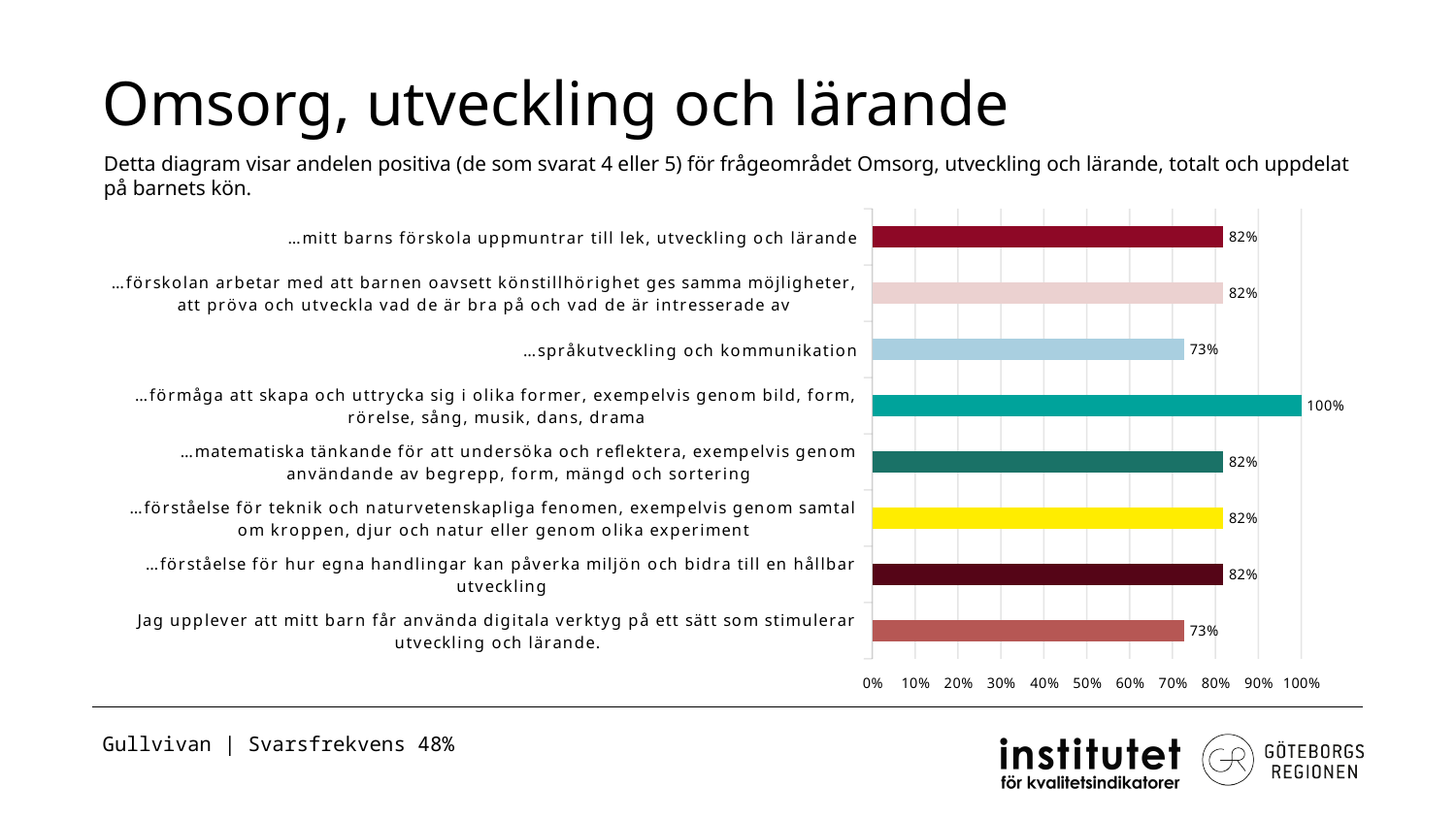
What is the value for "…förmåga att skapa och uttrycka sig i olika former, exempelvis genom bild, form, rörelse, sång, musik, dans, drama"? 100% How many categories are shown in the chart? 8 What is the value for "…språkutveckling och kommunikation"? 73% Which category has the highest value? …förmåga att skapa och uttrycka sig i olika former, exempelvis genom bild, form, rörelse, sång, musik, dans, drama What is the difference between the value for "…förmåga att skapa och uttrycka sig i olika former, exempelvis genom bild, form, rörelse, sång, musik, dans, drama" and the value for "…språkutveckling och kommunikation"? 27% Which is larger: the value for "…matematiska tänkande för att undersöka och reflektera, exempelvis genom användande av begrepp, form, mängd och sortering" or the value for "…språkutveckling och kommunikation"? …matematiska tänkande för att undersöka och reflektera, exempelvis genom användande av begrepp, form, mängd och sortering Is the value for "…språkutveckling och kommunikation" greater or less than 80%? less What is the value for "Jag upplever att mitt barn får använda digitala verktyg på ett sätt som stimulerar utveckling och lärande."? 73% What kind of chart is shown on the slide? bar chart What is the difference between the value for "…mitt barns förskola uppmuntrar till lek, utveckling och lärande" and the value for "Jag upplever att mitt barn får använda digitala verktyg på ett sätt som stimulerar utveckling och lärande."? 9% How many categories have a value of 82%? 5 What is the value for "…mitt barns förskola uppmuntrar till lek, utveckling och lärande"? 82%